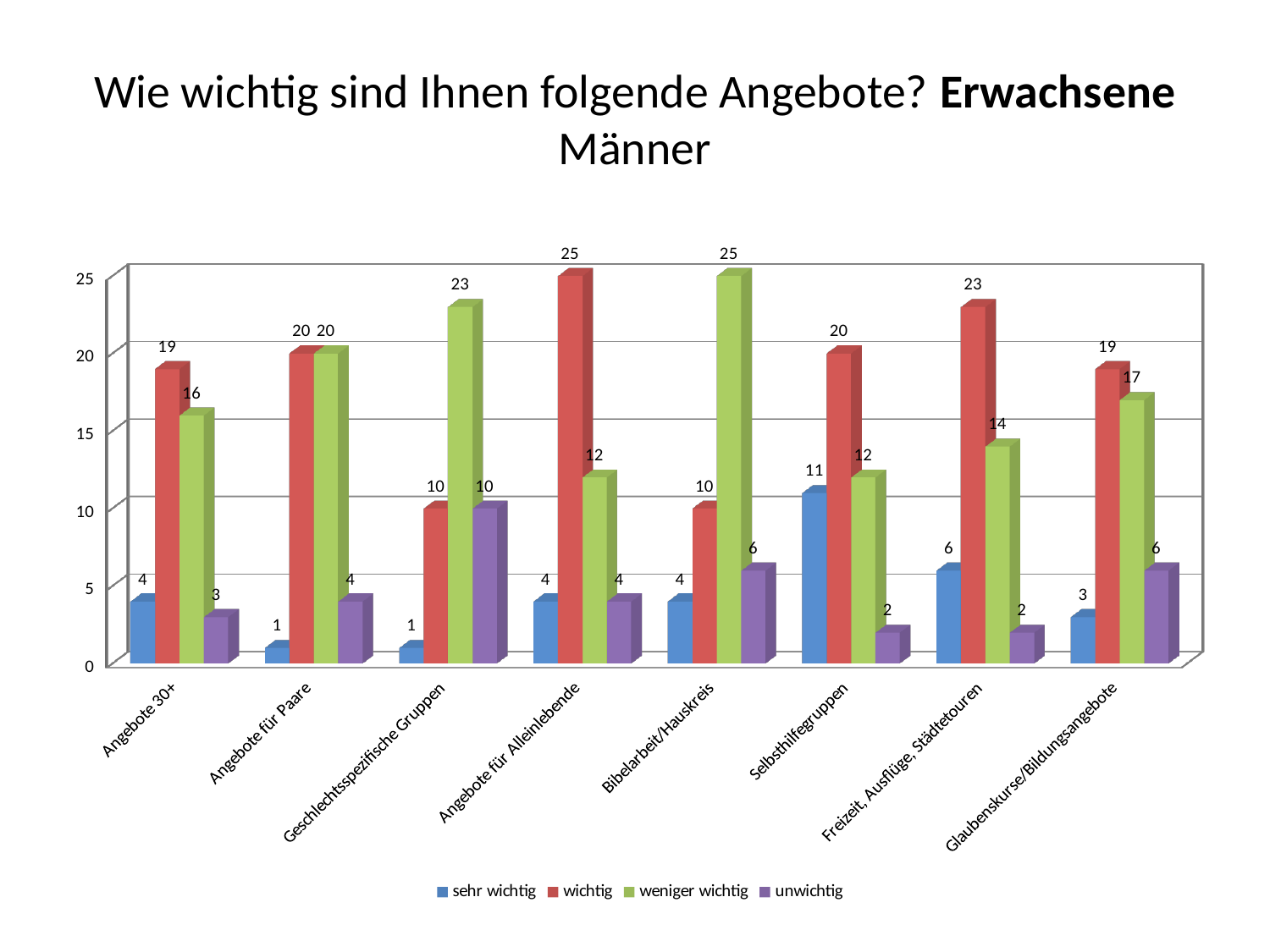
What is the value for "weniger wichtig" for Geschlechtsspezifische Gruppen? 23 Which is larger for Freizeit, Ausflüge, Städtetouren: the "wichtig" value or the "weniger wichtig" value? wichtig What is the difference between the "wichtig" and "weniger wichtig" values for Bibelarbeit/Hauskreis? 15 How many series does the legend list? 4 Which category has the highest value for "sehr wichtig"? Selbsthilfegruppen Which series is shown in green in the legend? weniger wichtig What is the value for "wichtig" for Angebote für Alleinlebende? 25 What is the value for "unwichtig" for Glaubenskurse/Bildungsangebote? 6 What kind of chart is shown on the slide? Bar chart How many categories are shown on the x axis? 8 What is the value for "sehr wichtig" for Selbsthilfegruppen? 11